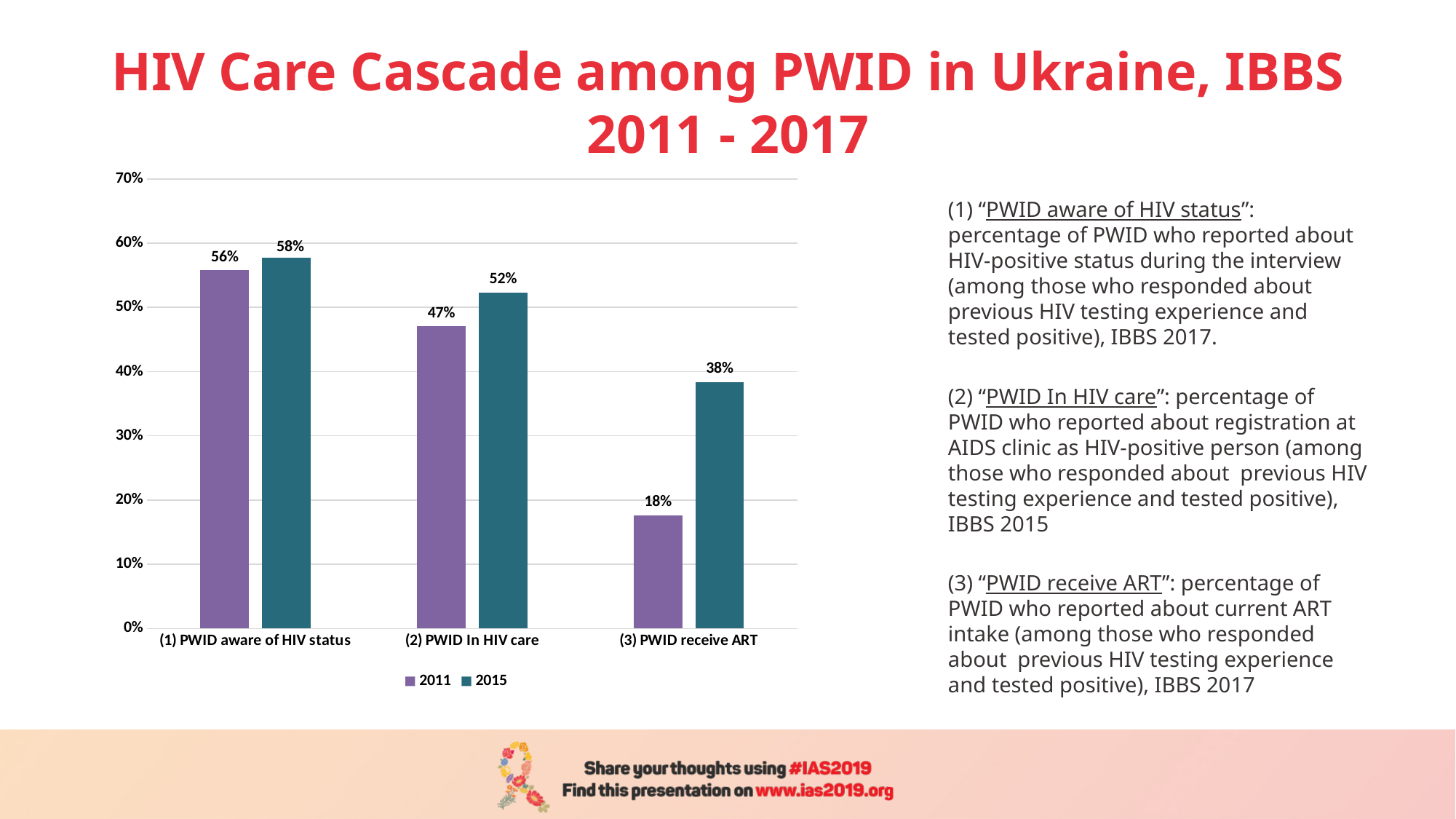
Which is larger: the 2011 value for (1) PWID aware of HIV status or the 2015 value for (2) PWID In HIV care? 2011 value for (1) PWID aware of HIV status Which category has the lowest 2011 value? (3) PWID receive ART Which category has the highest 2015 value? (1) PWID aware of HIV status What is the 2011 value for (1) PWID aware of HIV status? 56% How many series does the legend list? 2 How many categories are shown on the x axis? 3 What is the difference between the 2015 and 2011 values for (3) PWID receive ART? 20% What kind of chart is shown on the slide? Bar chart What is the difference between the 2015 and 2011 values for (2) PWID In HIV care? 5% What is the 2011 value for (2) PWID In HIV care? 47% Which series is shown in purple in the legend? 2011 What is the 2015 value for (3) PWID receive ART? 38%